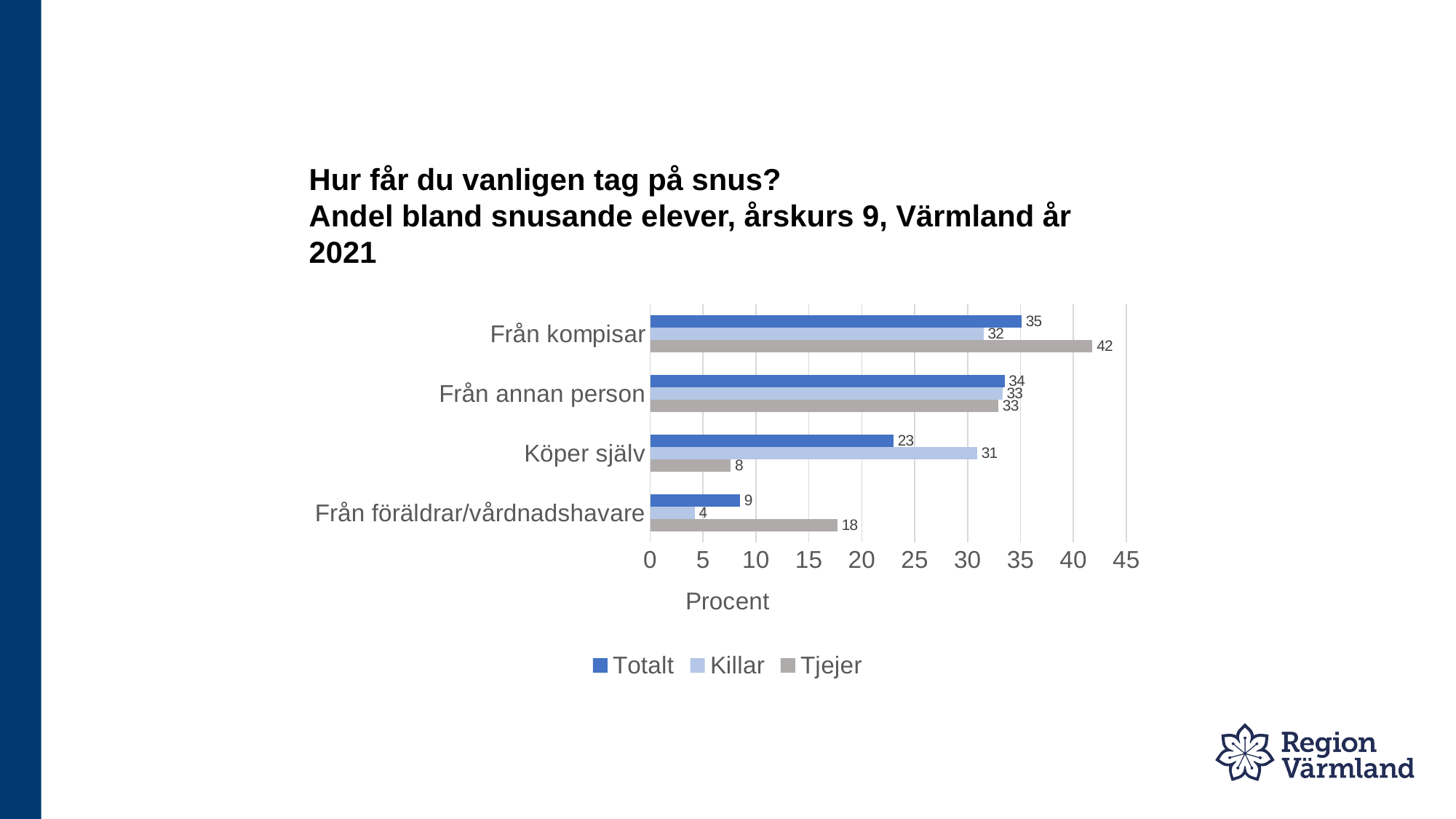
What kind of chart is shown on the slide? bar chart What is the label of the horizontal axis? Procent What is the difference between the Killar and Tjejer values for Köper själv? 23 How many series does the legend list? 3 For Från föräldrar/vårdnadshavare, which is larger: the Killar value or the Tjejer value? Tjejer What is the Tjejer value for Från kompisar? 42 What is the difference between the Tjejer and Killar values for Från kompisar? 10 What is the Totalt value for Från föräldrar/vårdnadshavare? 9 Which category has the highest Tjejer value? Från kompisar What is the Killar value for Köper själv? 31 Which category has the lowest Killar value? Från föräldrar/vårdnadshavare How many categories are shown on the chart? 4